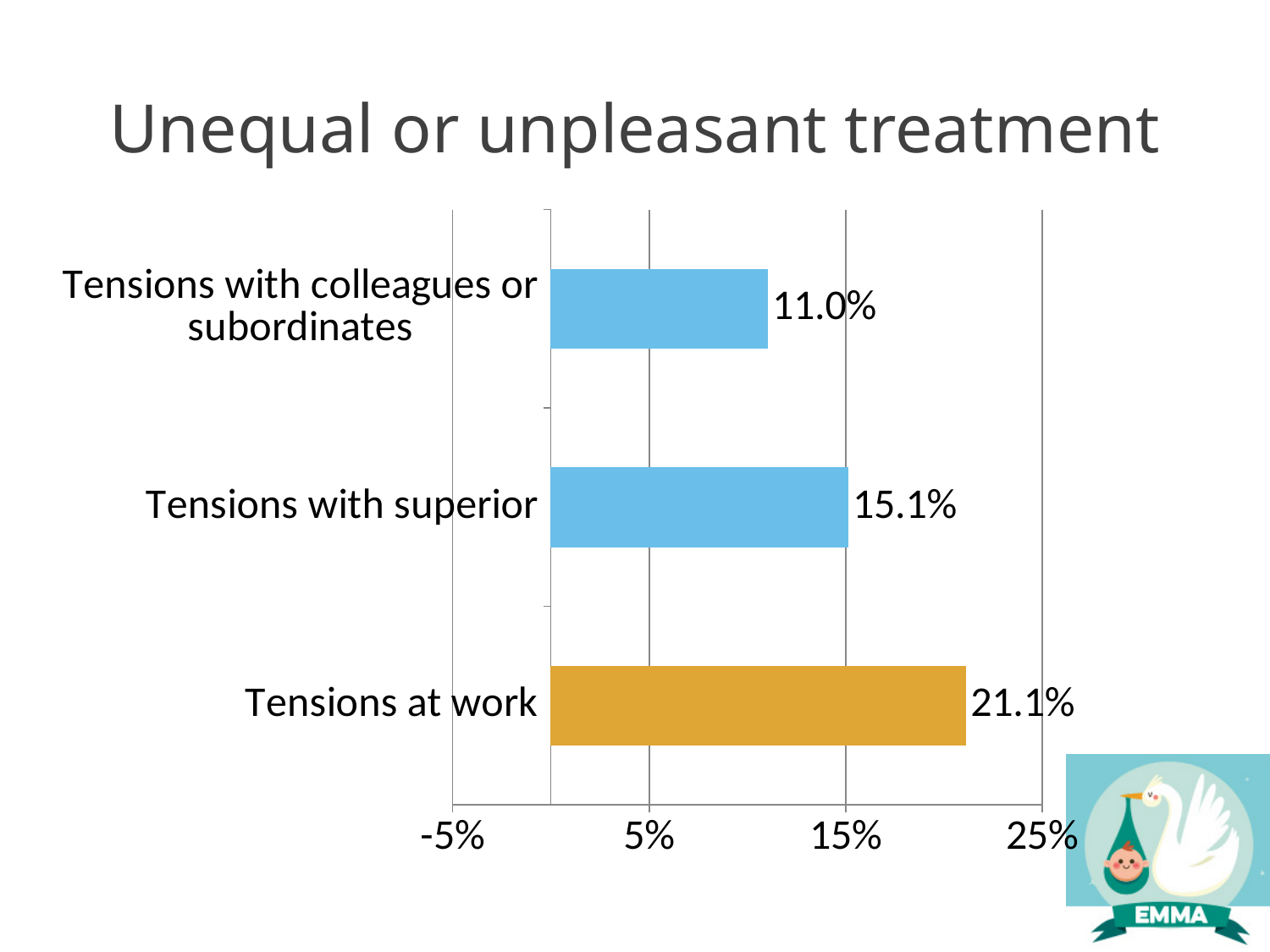
Is the value for Tensions at work greater or less than 15%? greater What kind of chart is shown on the slide? Bar chart What is the difference between the values for Tensions with superior and Tensions with colleagues or subordinates? 4.1% What is the value for Tensions at work? 21.1% What is the value for Tensions with colleagues or subordinates? 11.0% Which category has the lowest value? Tensions with colleagues or subordinates What is the value for Tensions with superior? 15.1% How many categories are shown in the chart? 3 What is the title of the slide? Unequal or unpleasant treatment Which category has the highest value? Tensions at work Which is larger, the value for Tensions with superior or the value for Tensions with colleagues or subordinates? Tensions with superior What is the difference between the values for Tensions at work and Tensions with superior? 6.0%